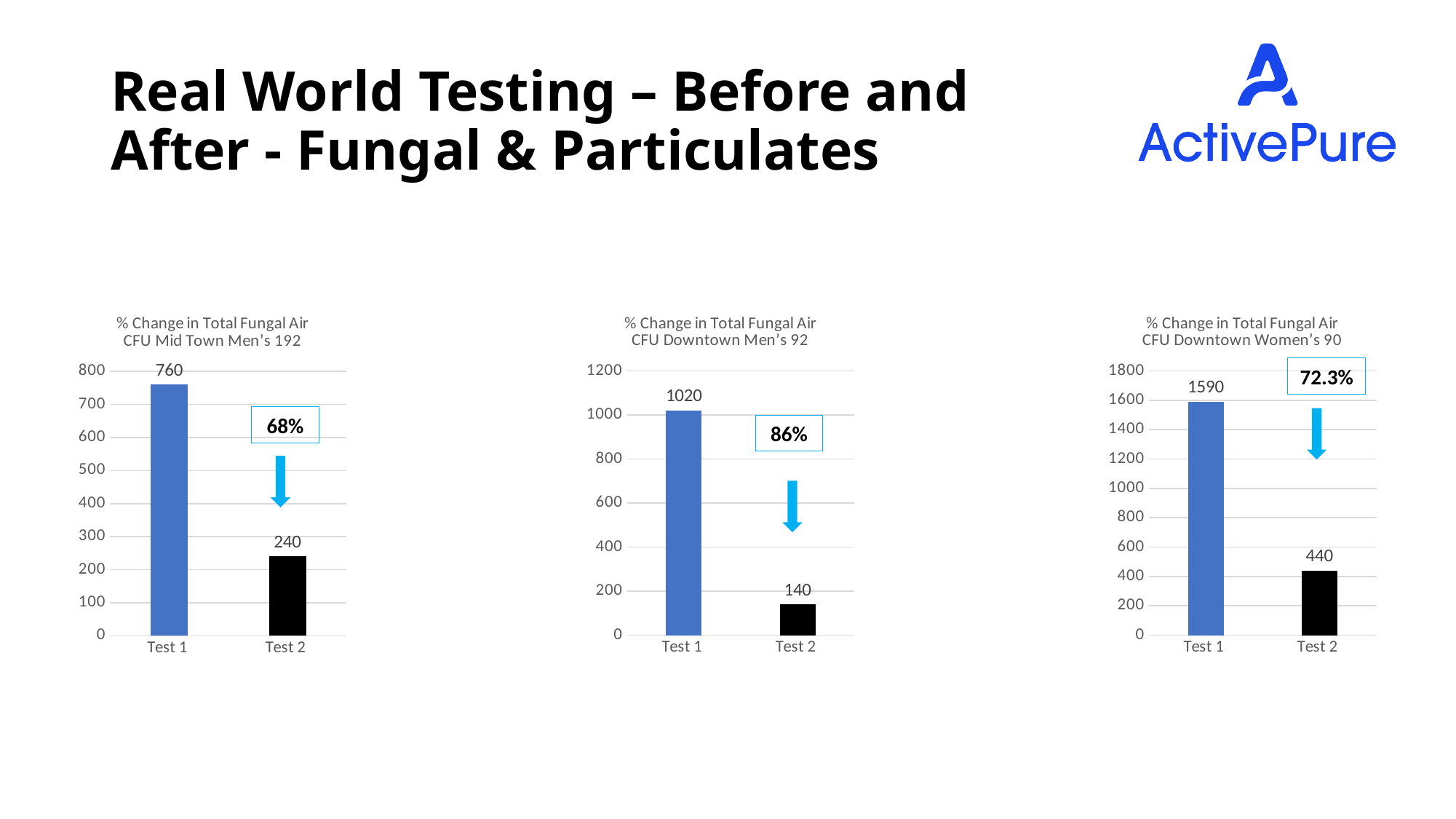
In the 'CFU Downtown Women's 90' chart, what percentage change is shown in the box above the arrow? 72.3% In the 'CFU Mid Town Men's 192' chart, what is the value for Test 1? 760 In the 'CFU Downtown Women's 90' chart, which test has the higher value? Test 1 In the 'CFU Downtown Women's 90' chart, what is the value for Test 1? 1590 What kind of chart is the 'CFU Downtown Men's 92' chart? bar chart In the 'CFU Downtown Men's 92' chart, what is the difference between Test 1 and Test 2? 880 In the 'CFU Downtown Men's 92' chart, what is the value for Test 1? 1020 In the 'CFU Downtown Women's 90' chart, what is the value for Test 2? 440 In the 'CFU Downtown Men's 92' chart, what is the value for Test 2? 140 In the 'CFU Mid Town Men's 192' chart, what is the difference between Test 1 and Test 2? 520 In the 'CFU Mid Town Men's 192' chart, what is the value for Test 2? 240 How many categories are shown on the x axis of the 'CFU Mid Town Men's 192' chart? 2